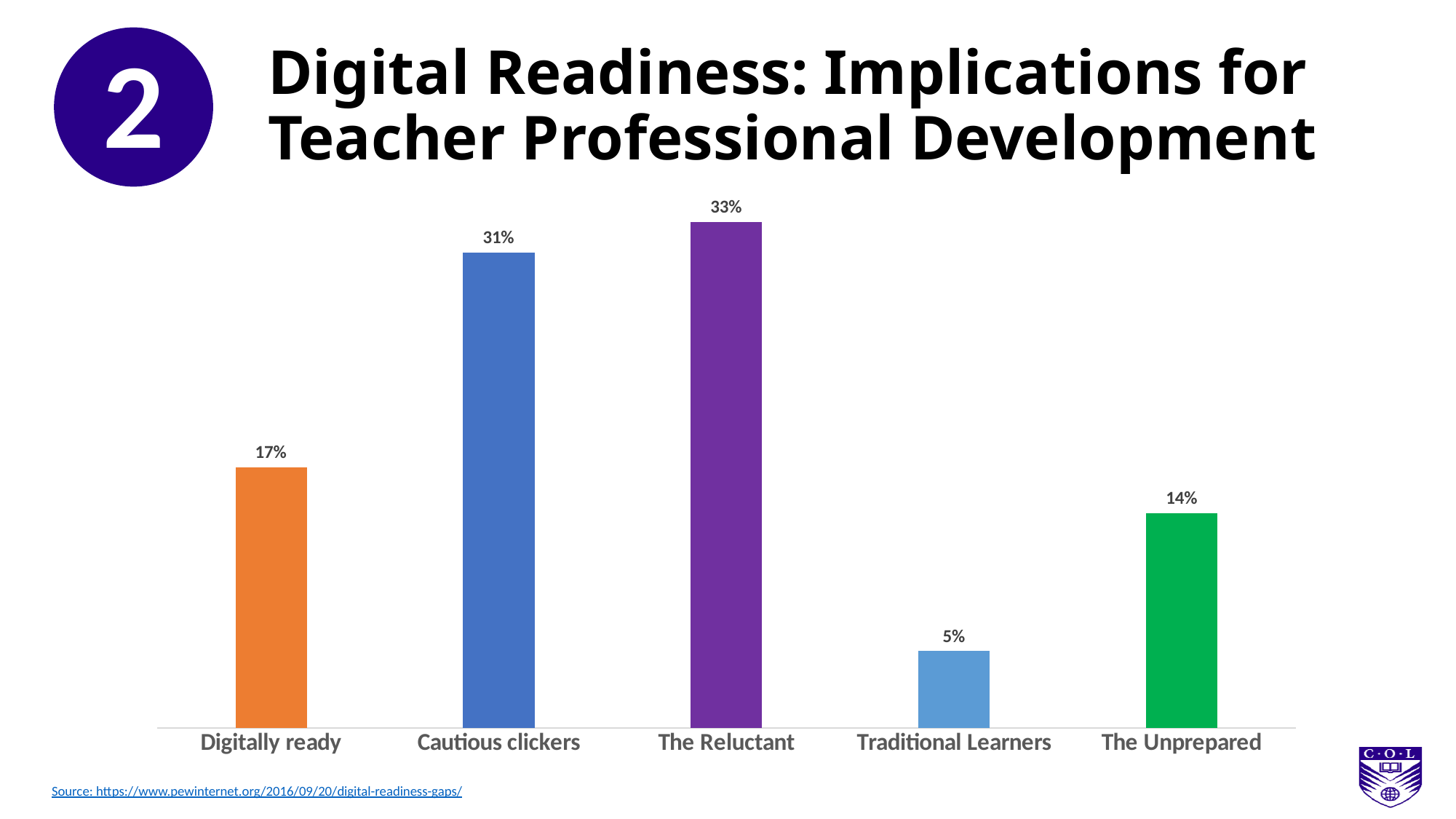
Which category has the lowest value? Traditional Learners Which category has the highest value? The Reluctant What kind of chart is shown on the slide? Bar chart What is the value for Traditional Learners? 5% What colour is the bar for The Reluctant? Purple What is the difference between the values for Digitally ready and The Unprepared? 3% How many categories are shown on the x axis? 5 What is the value for Digitally ready? 17% What is the value for Cautious clickers? 31% What is the difference between the values for The Reluctant and Cautious clickers? 2% What is the value for The Unprepared? 14% Which is larger, the value for Digitally ready or the value for The Unprepared? Digitally ready